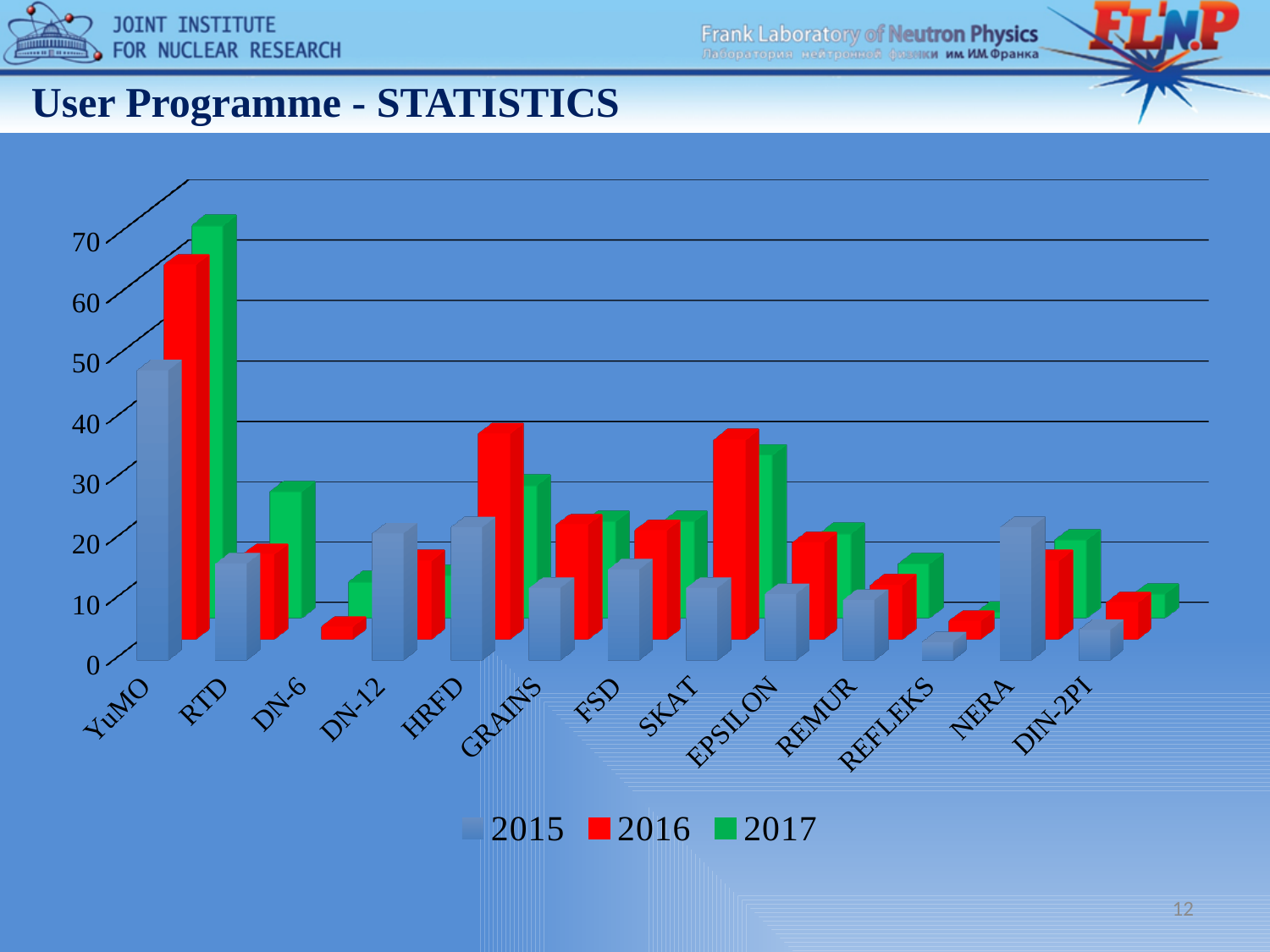
Is the 2017 value for YuMO greater or less than 60? greater How many instruments (categories) are shown along the x axis? 13 Is the 2016 value for YuMO greater or less than 50? greater Which instrument has the highest value for 2017? YuMO Which colour represents the 2016 series in the legend? red For HRFD, which is larger: the 2016 value or the 2017 value? 2016 Is the 2016 value for HRFD greater or less than 30? greater For RTD, which is larger: the 2015 value or the 2017 value? 2017 Which instrument has the highest value for 2016? YuMO How many series does the legend list? 3 What kind of chart is shown on the slide? bar chart